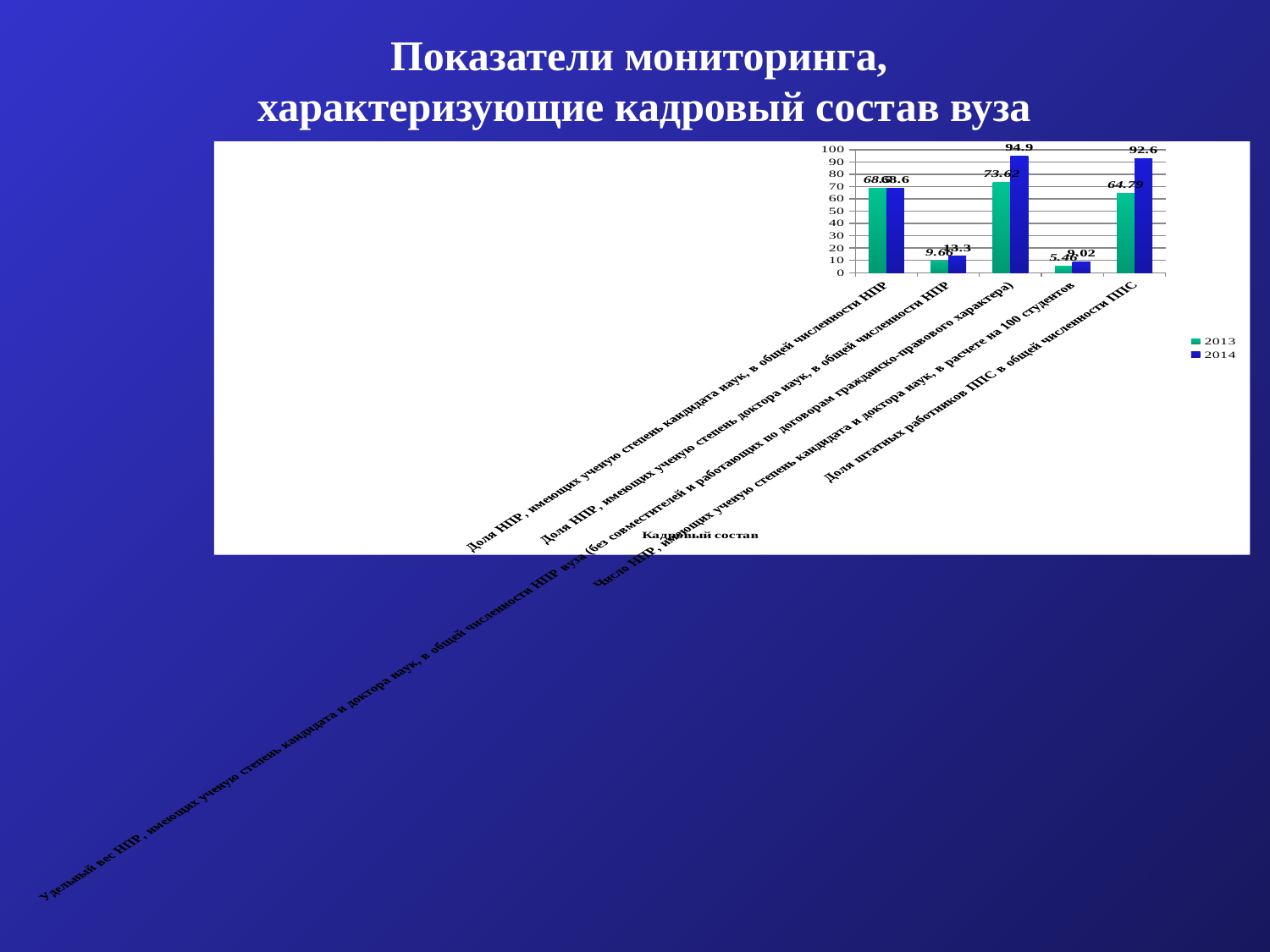
What is the 2014 value for the third category from the left? 94.9 How many series does the legend list? 2 What are the two legend entries of the chart? 2013 and 2014 What kind of chart is shown on the slide? bar chart What is the 2014 value for 'Доля штатных работников ППС в общей численности ППС'? 92.6 How many categories are plotted along the x axis? 5 What is the 2014 value for 'Число НПР, имеющих ученую степень кандидата и доктора наук, в расчете на 100 студентов'? 9.02 What is the difference between the 2014 and 2013 values for 'Доля штатных работников ППС в общей численности ППС'? 27.81 What is the 2013 value for 'Доля штатных работников ППС в общей численности ППС'? 64.79 What is the 2013 value for the third category from the left? 73.62 Which category has the highest 2014 value? the third category from the left (94.9) Which category has the lowest 2013 value? Число НПР, имеющих ученую степень кандидата и доктора наук, в расчете на 100 студентов (5.46)